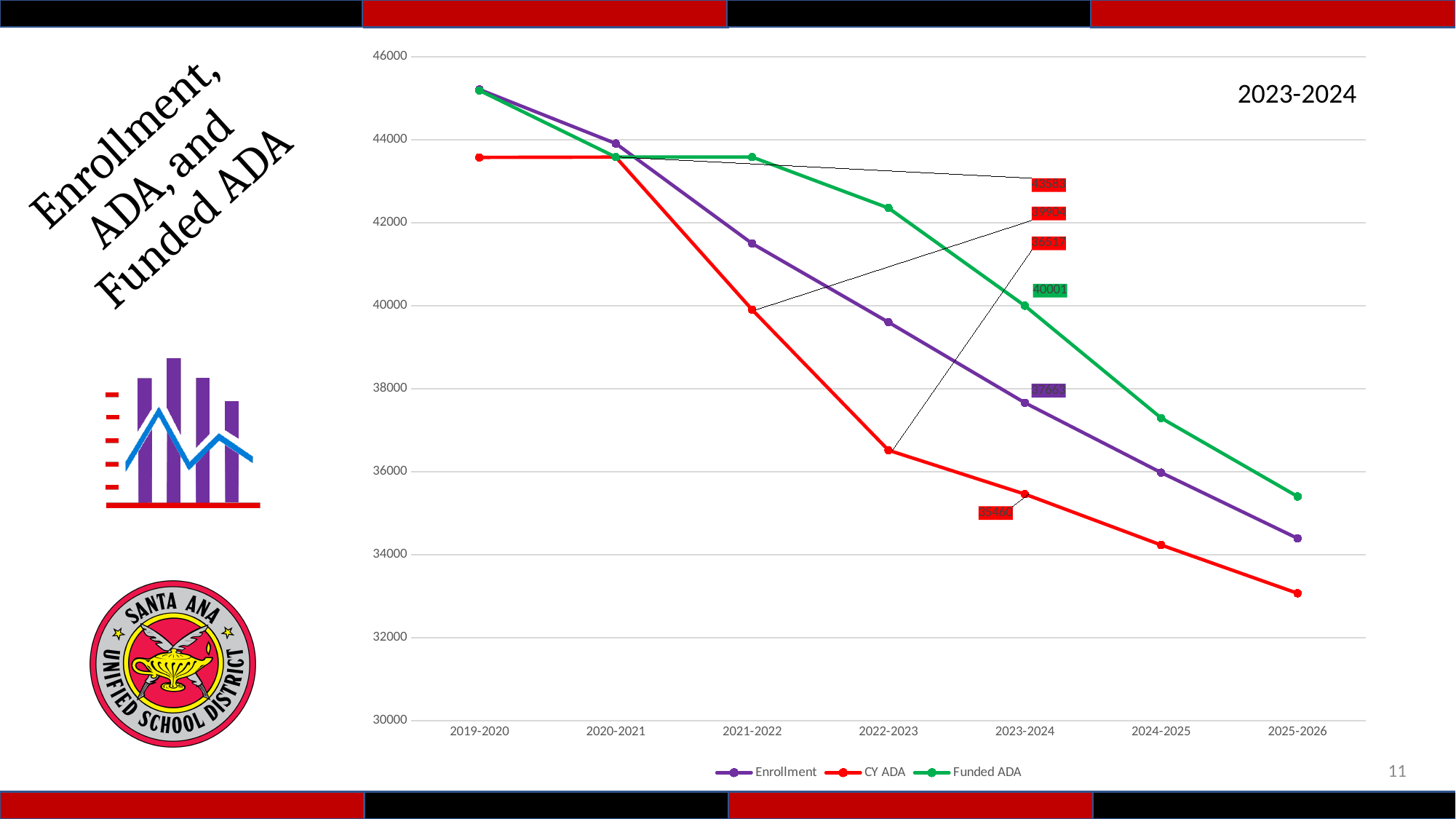
How many school years are shown on the x axis? 7 Is the Enrollment value for 2019-2020 greater or less than 44000? greater What is the Funded ADA value for 2023-2024? 40001 In 2025-2026, which is larger: Funded ADA or CY ADA? Funded ADA What is the difference between Funded ADA and Enrollment in 2023-2024? 2338 What is the Enrollment value for 2023-2024? 37663 What is the difference between Enrollment and CY ADA in 2023-2024? 2203 What is the CY ADA value for 2023-2024? 35460 Which series has the highest value in 2023-2024? Funded ADA How many series does the legend list? 3 What kind of chart is shown on the slide? line chart Does Enrollment rise or fall from 2019-2020 to 2025-2026? fall